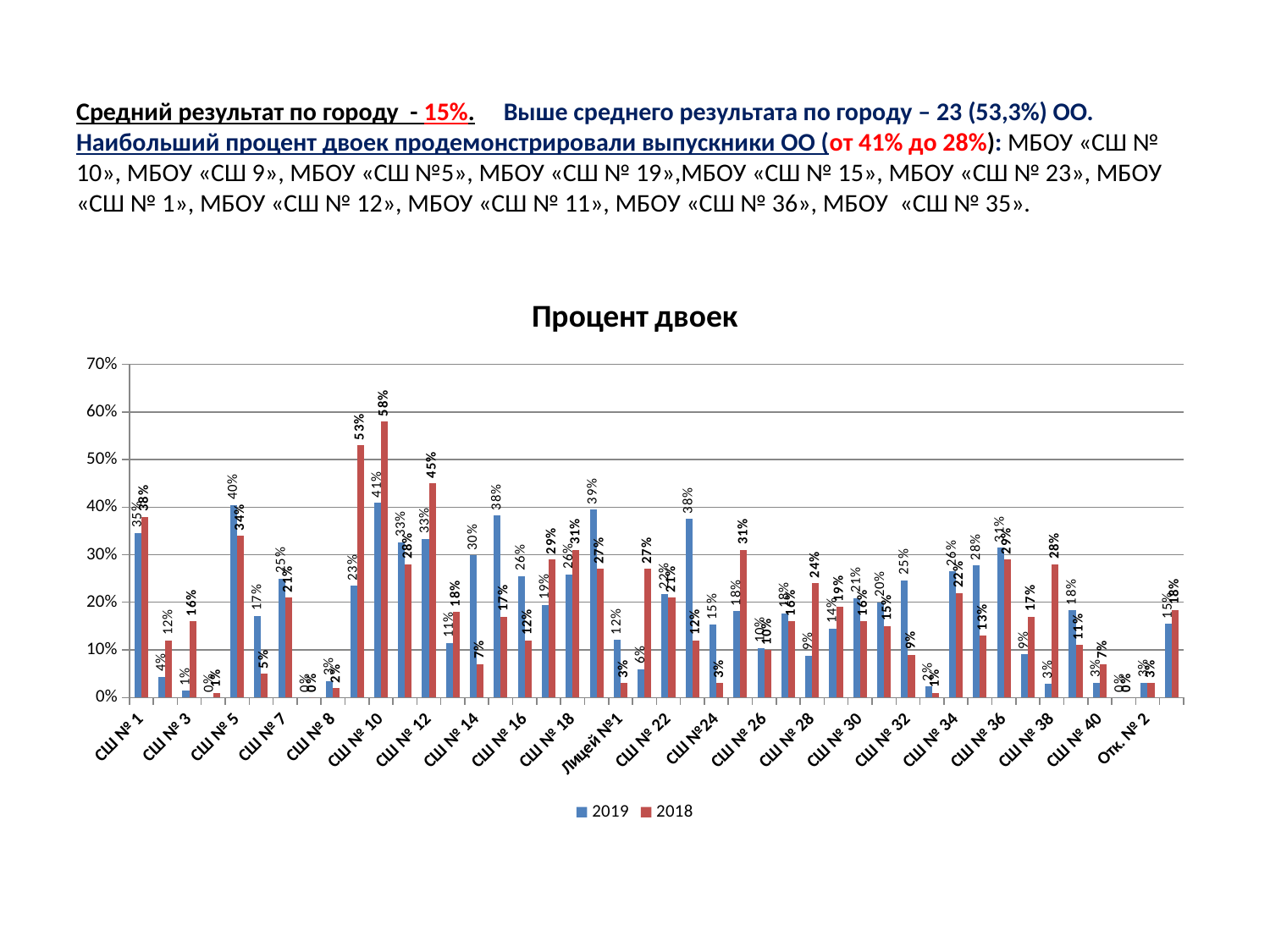
What is the highest value in the 2018 series? 58% How many series does the legend of the chart list? 2 Is the highest value in the 2018 series greater or less than 50%? greater What is the 2019 value for СШ № 1? 35% What is the difference between the 2018 and 2019 values for СШ № 1? 3% For СШ № 1, which series has the larger value, 2019 or 2018? 2018 What is the highest value in the 2019 series? 41% What is the maximum value shown on the vertical axis of the chart? 70% What is the title of the chart? Процент двоек What are the two series named in the chart legend? 2019 and 2018 What is the 2018 value for СШ № 1? 38% What kind of chart is shown on the slide? bar chart